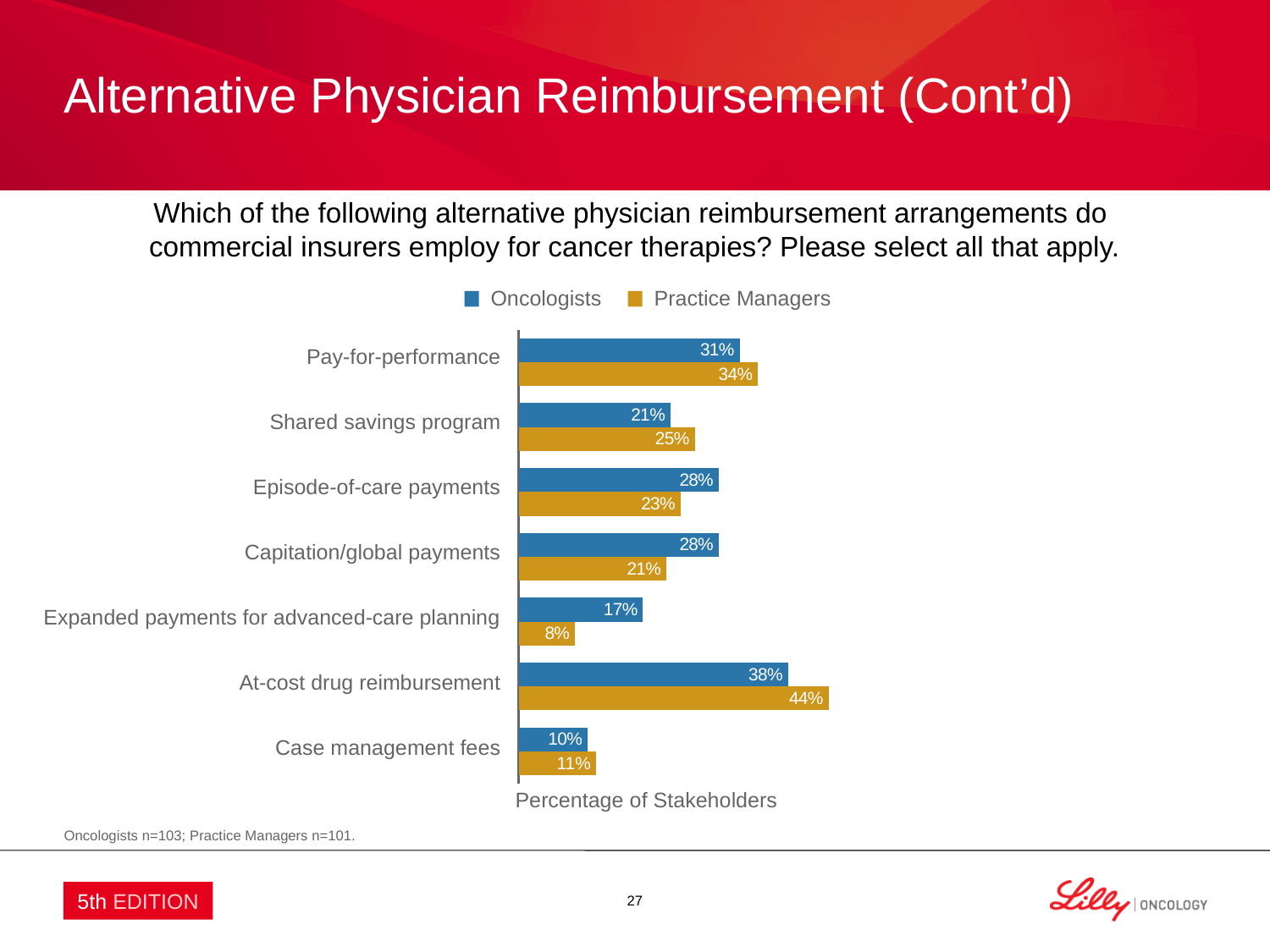
What percentage of Practice Managers selected At-cost drug reimbursement? 44% For Episode-of-care payments, which group has the larger value, Oncologists or Practice Managers? Oncologists Which category has the lowest value for Practice Managers? Expanded payments for advanced-care planning What is the label on the horizontal axis of the chart? Percentage of Stakeholders What is the difference between the Practice Managers and Oncologists values for Shared savings program? 4% What kind of chart is shown on the slide? Bar chart How many series does the legend list? 2 What is the difference between the Oncologists and Practice Managers values for Expanded payments for advanced-care planning? 9% What percentage of Oncologists selected Pay-for-performance? 31% What percentage of Practice Managers selected Expanded payments for advanced-care planning? 8% How many reimbursement arrangement categories are shown on the chart? 7 Which category has the highest value for Oncologists? At-cost drug reimbursement